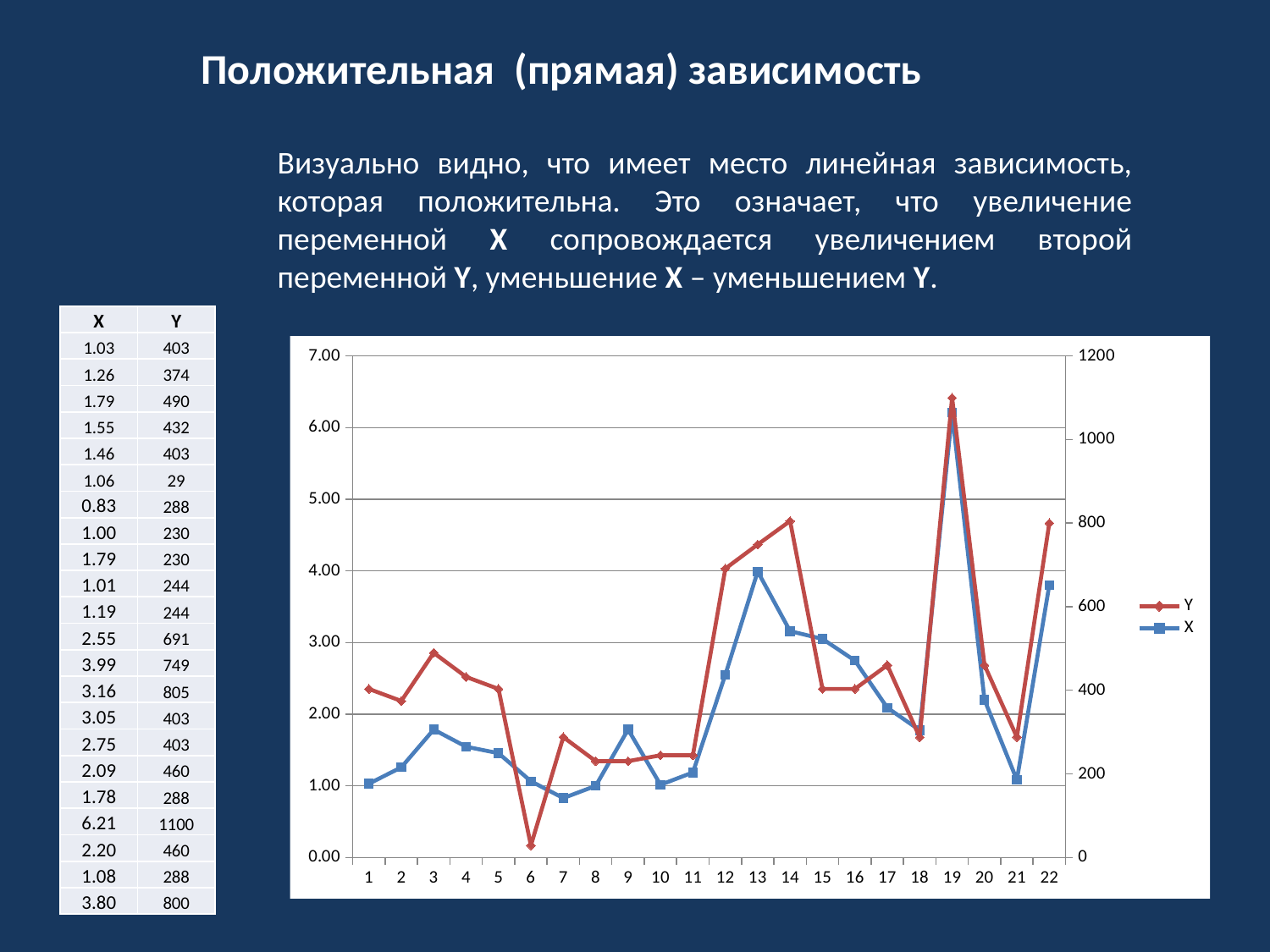
Which is larger for the X series: the value at point 13 or the value at point 14? point 13 How many series does the chart legend list? 2 Is the value of the Y series at point 6 greater or less than 200? less How many points are plotted along the x axis of the chart? 22 What kind of chart is shown on the slide? line chart At which x-axis point does the X series reach its lowest value? 7 Which colour is used for the Y series line in the chart? red At which x-axis point does the Y series reach its highest value? 19 At which x-axis point does the X series reach its highest value? 19 At which x-axis point does the Y series reach its lowest value? 6 Is the value of the X series at point 12 greater or less than 2.00? greater Is the value of the Y series at point 13 greater or less than 600? greater